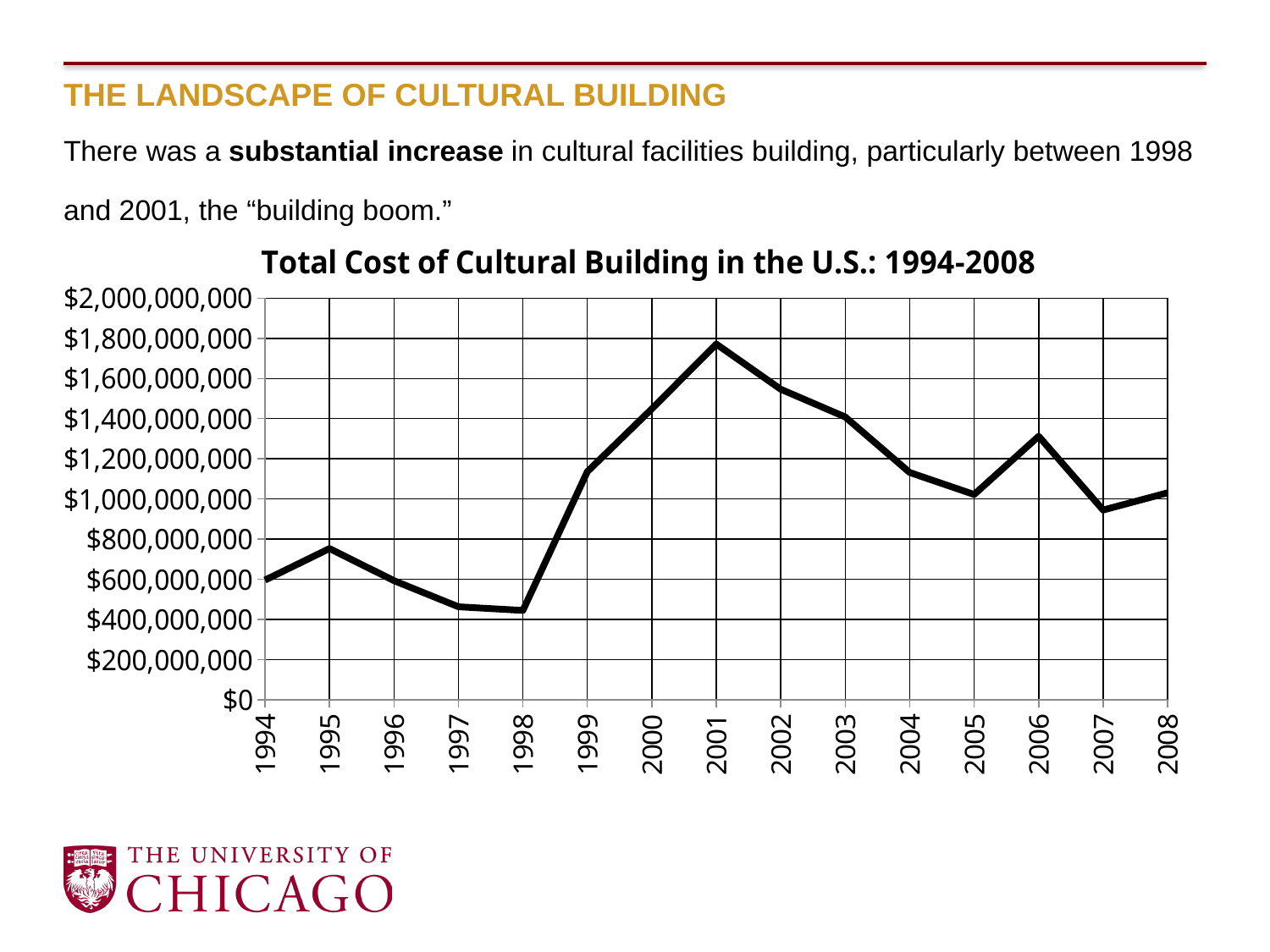
Which year has the larger value, 2006 or 2007? 2006 Is the value for 1998 greater or less than $600,000,000? less Is the value for 2001 greater or less than $1,600,000,000? greater Is the value for 1999 greater or less than $1,000,000,000? greater In which year is the total cost of cultural building highest? 2001 Does the total cost rise or fall between 1998 and 2001? Rise What kind of chart is shown on the slide? Line chart Which year has the larger value, 1994 or 2001? 2001 How many years are plotted on the x axis of the chart? 15 What is the title of the chart? Total Cost of Cultural Building in the U.S.: 1994-2008